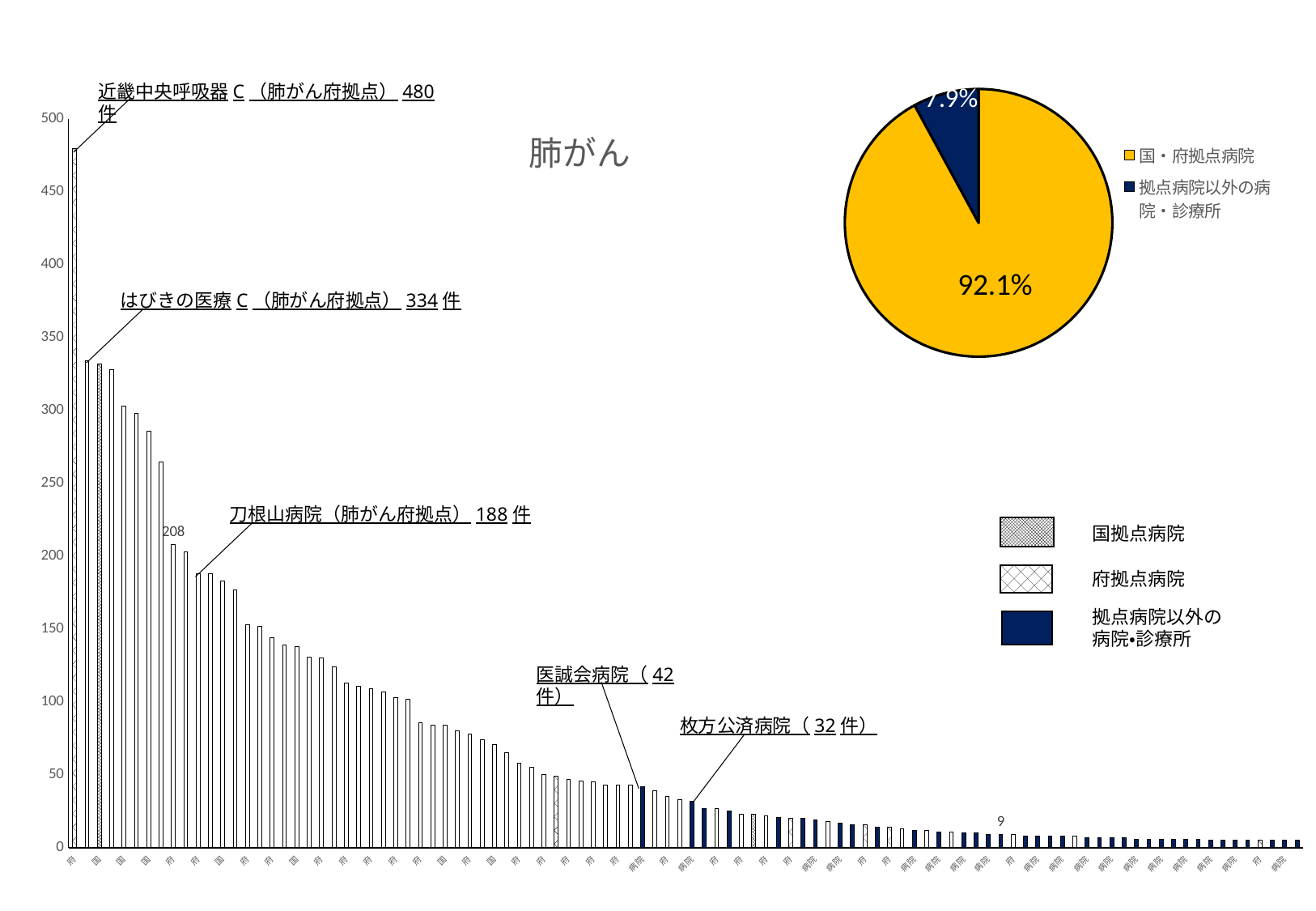
In the 肺がん bar chart, how many cases are annotated for 枚方公済病院? 32件 In the pie chart, what share is shown for 拠点病院以外の病院・診療所? 7.9% How many slices does the pie chart have? 2 In the 肺がん bar chart, how many cases are annotated for 近畿中央呼吸器C (肺がん府拠点)? 480件 In the 肺がん bar chart, how many cases are annotated for はびきの医療C (肺がん府拠点)? 334件 In the 肺がん bar chart, how many cases are annotated for 医誠会病院? 42件 In the 肺がん bar chart, do the values rise or fall from left to right along the x axis? fall In the 肺がん bar chart, how many cases are annotated for 刀根山病院 (肺がん府拠点)? 188件 In the 肺がん bar chart, what is the difference in cases between 近畿中央呼吸器C and はびきの医療C? 146件 In the pie chart, which slice is larger, 国・府拠点病院 or 拠点病院以外の病院・診療所? 国・府拠点病院 What kind of chart is the 肺がん chart on the left of the slide? bar chart In the pie chart, what share is shown for 国・府拠点病院? 92.1%